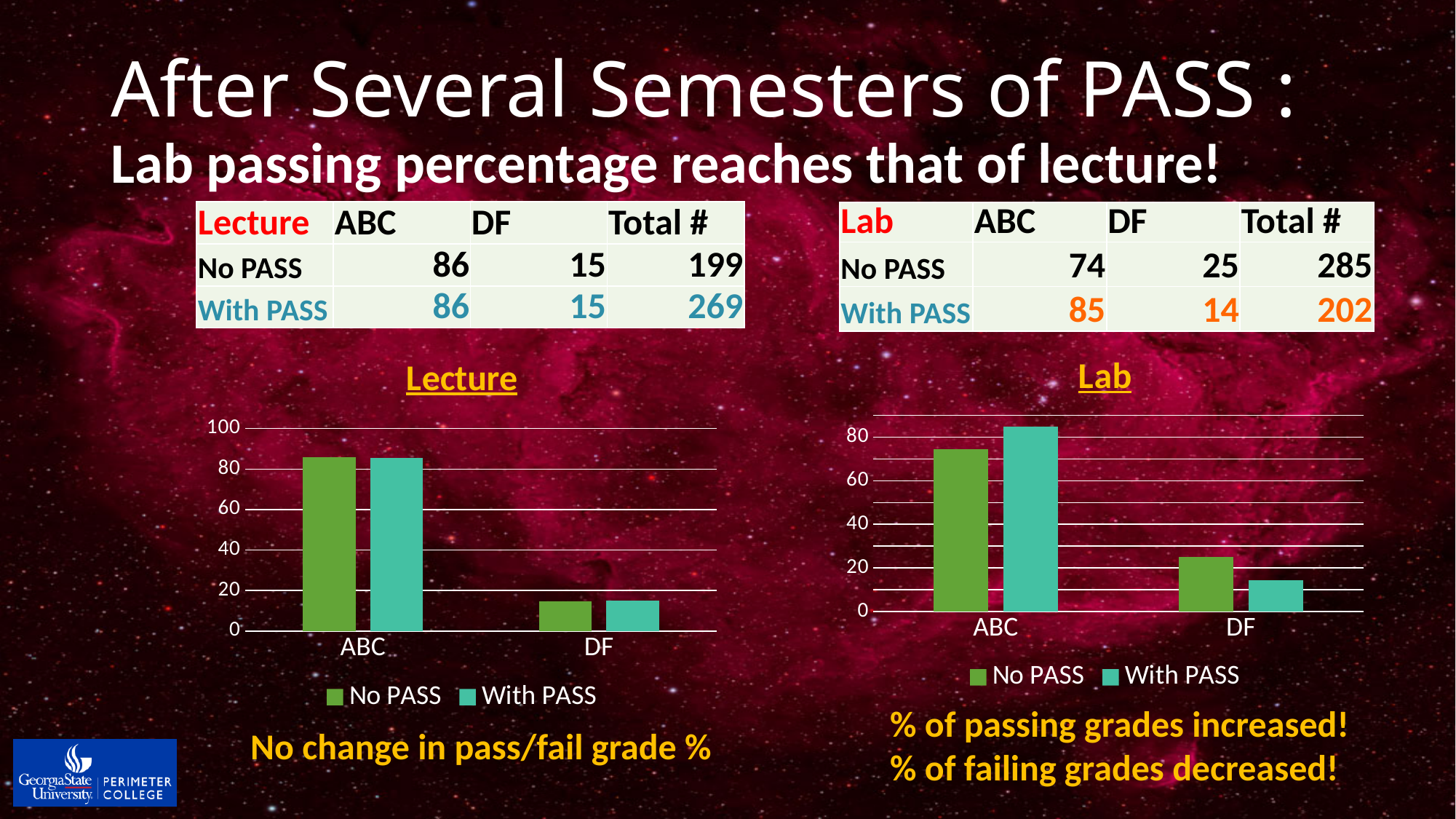
How many series does the legend of the Lab chart list? 2 Which series is shown in green in the Lecture chart's legend? No PASS In the Lab chart, is the With PASS value for ABC greater or less than 80? greater What type of chart is the Lecture chart? bar chart What is the With PASS value for ABC in the Lab chart, as given in the Lab table on the slide? 85 In the Lab chart, which series has the larger value for DF, No PASS or With PASS? No PASS In the Lab chart, which series has the larger value for ABC, No PASS or With PASS? With PASS In the Lab chart, which category has the highest With PASS value? ABC In the Lecture chart, is the No PASS value for DF greater or less than 20? less How many categories are shown on the x axis of the Lecture chart? 2 In the Lecture chart, which category has the lowest No PASS value? DF In the Lab chart, is the No PASS value for DF greater or less than 20? greater